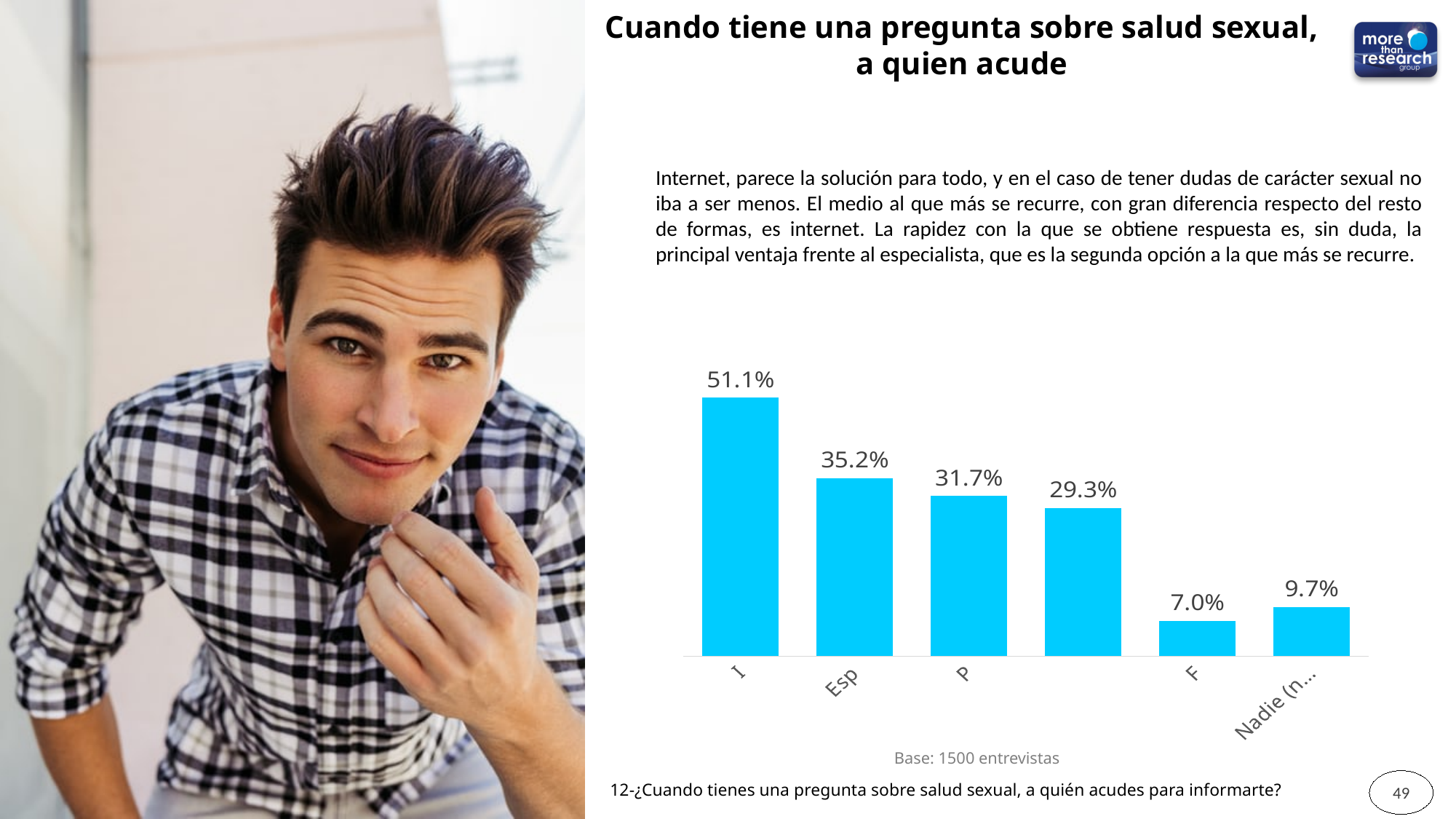
What is the difference between the values for "Nadie (n..." and "F"? 2.7% Which category has the lowest value? F What is the value for the category "F"? 7.0% What kind of chart is shown on the slide? Bar chart Which category has the highest value? I What is the value for the category "I"? 51.1% How many bars are shown in the chart? 6 What is the value for the category "P"? 31.7% What is the difference between the values for "I" and "Esp"? 15.9% Which is larger, the value for "Esp" or the value for "P"? Esp What is the value for the category "Esp"? 35.2% What base (number of interviews) is stated below the chart? 1500 entrevistas